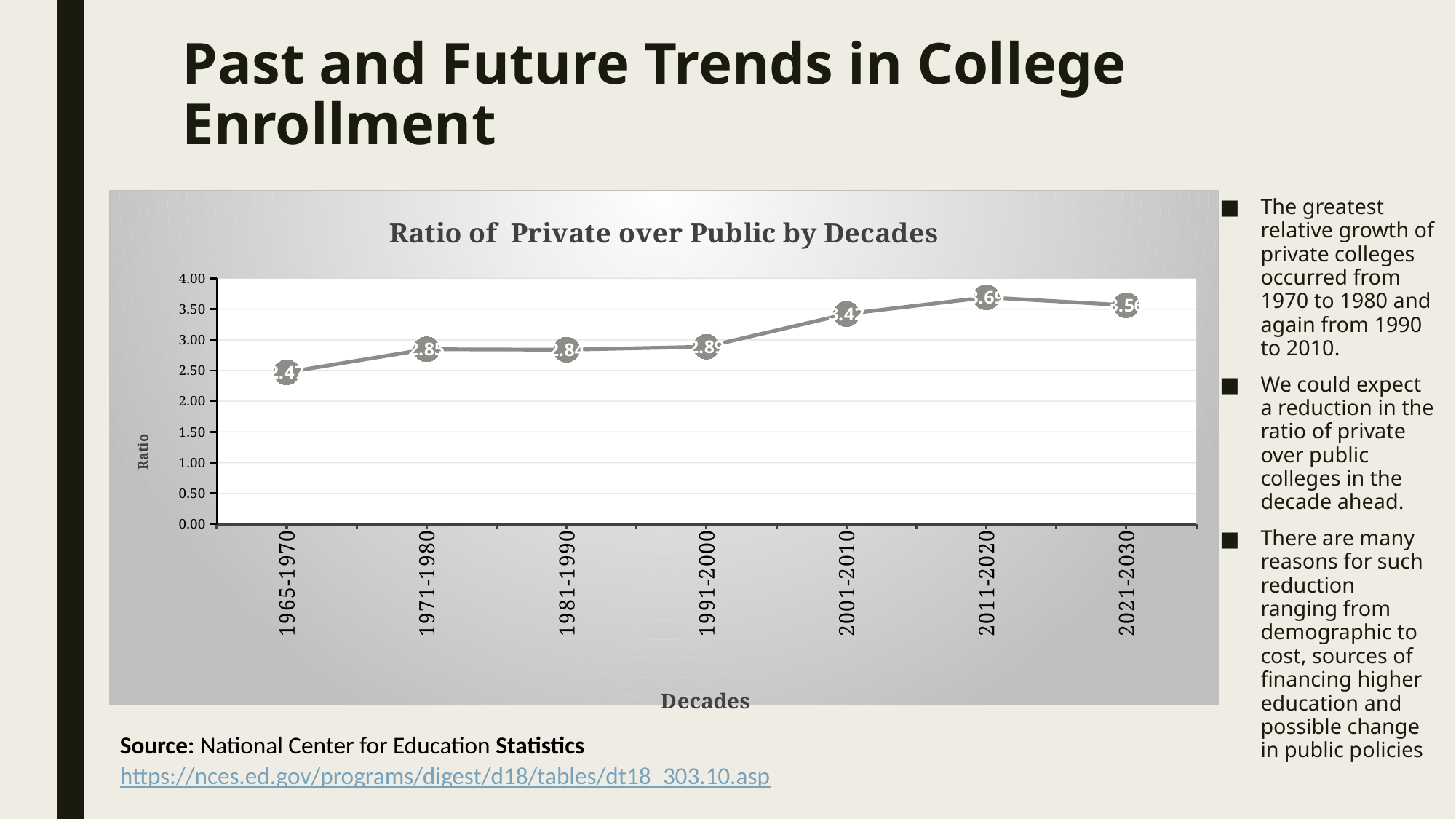
What is the difference between the ratio for 2001-2010 and the ratio for 1991-2000? 0.53 What is the ratio value for 1971-1980? 2.85 How many decade categories are plotted on the x axis? 7 Which decade has the highest ratio? 2011-2020 Which is larger, the ratio for 2001-2010 or the ratio for 1981-1990? 2001-2010 What type of chart is shown on the slide? line chart Does the ratio rise or fall from 2011-2020 to 2021-2030? fall What is the ratio value for 1991-2000? 2.89 Which decade has the lowest ratio? 1965-1970 What is the title of the chart? Ratio of Private over Public by Decades What is the ratio value for 2001-2010? 3.42 Is the ratio for 2021-2030 greater or less than 3.00? greater